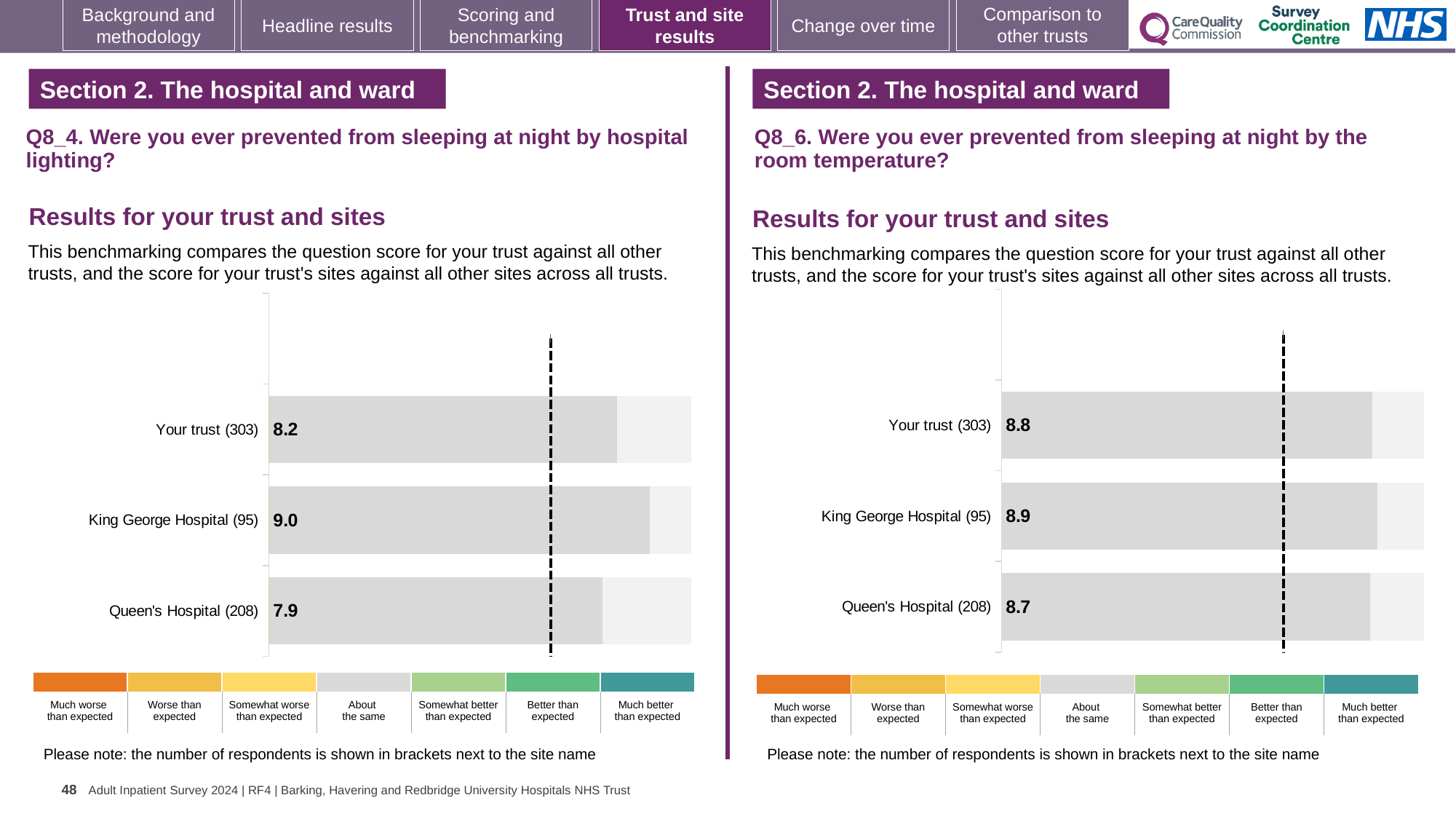
In the Q8_4 hospital lighting chart, what is the score for King George Hospital (95)? 9.0 In the Q8_6 room temperature chart, what is the difference between the scores for Your trust (303) and Queen's Hospital (208)? 0.1 In the Q8_6 room temperature chart, what is the score for Your trust (303)? 8.8 How many bars are plotted in the Q8_6 room temperature chart? 3 In the Q8_4 hospital lighting chart, which site or trust has the highest score? King George Hospital (95) In the Q8_4 hospital lighting chart, what is the score for Queen's Hospital (208)? 7.9 In the Q8_6 room temperature chart, what is the score for King George Hospital (95)? 8.9 In the Q8_4 hospital lighting chart, what is the score for Your trust (303)? 8.2 What kind of chart is used for the Q8_4 hospital lighting results? Bar chart In the Q8_4 hospital lighting chart, which site or trust has the lowest score? Queen's Hospital (208) In the Q8_4 hospital lighting chart, what is the difference between the scores for King George Hospital (95) and Queen's Hospital (208)? 1.1 In the Q8_6 room temperature chart, what is the score for Queen's Hospital (208)? 8.7